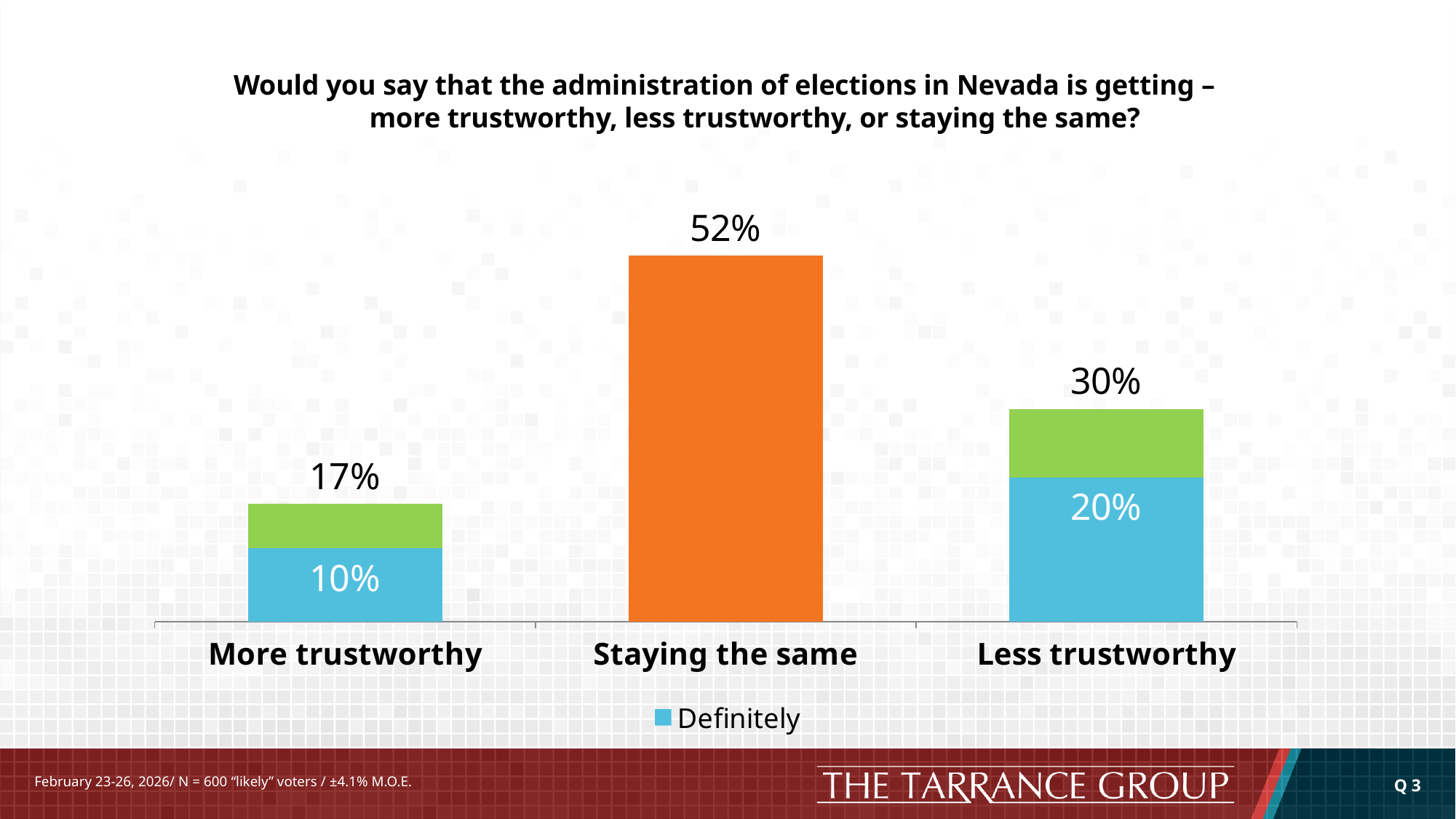
Which response category has the highest percentage? Staying the same Which response category has the lowest total percentage? More trustworthy How many series does the legend list? 1 What kind of chart is shown on the slide? Bar chart What percentage of respondents said the administration of elections in Nevada is staying the same? 52% What is the difference between the "Staying the same" percentage and the "Less trustworthy" total? 22% What is the "Definitely" value for "More trustworthy"? 10% What is the total percentage shown for "More trustworthy"? 17% Which is larger: the total for "Less trustworthy" or the total for "More trustworthy"? Less trustworthy What is the "Definitely" value for "Less trustworthy"? 20% How many response categories are shown on the x axis? 3 What is the total percentage shown for "Less trustworthy"? 30%